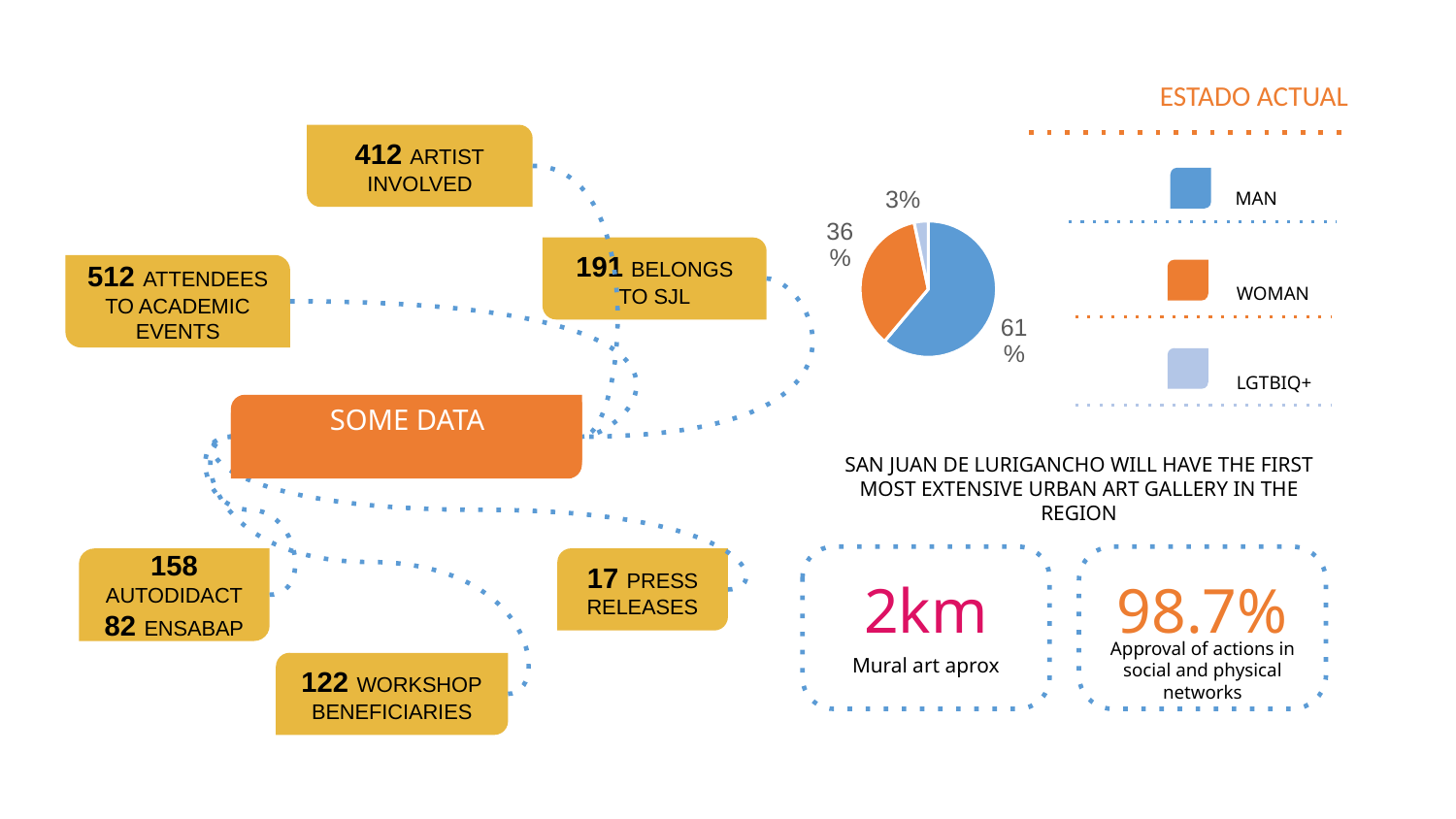
Which category has the smallest slice in the pie chart? LGTBIQ+ Which slice is larger in the pie chart, WOMAN or LGTBIQ+? WOMAN What is the difference in percentage points between the MAN and WOMAN slices? 25 How many slices does the pie chart have? 3 What share of the pie chart does MAN represent? 61% What colour is the WOMAN slice in the pie chart? orange What share of the pie chart does LGTBIQ+ represent? 3% Which category has the largest slice in the pie chart? MAN What colour is the MAN slice in the pie chart? blue How many entries does the pie chart legend list? 3 What share of the pie chart does WOMAN represent? 36% What type of chart is shown on the slide? pie chart